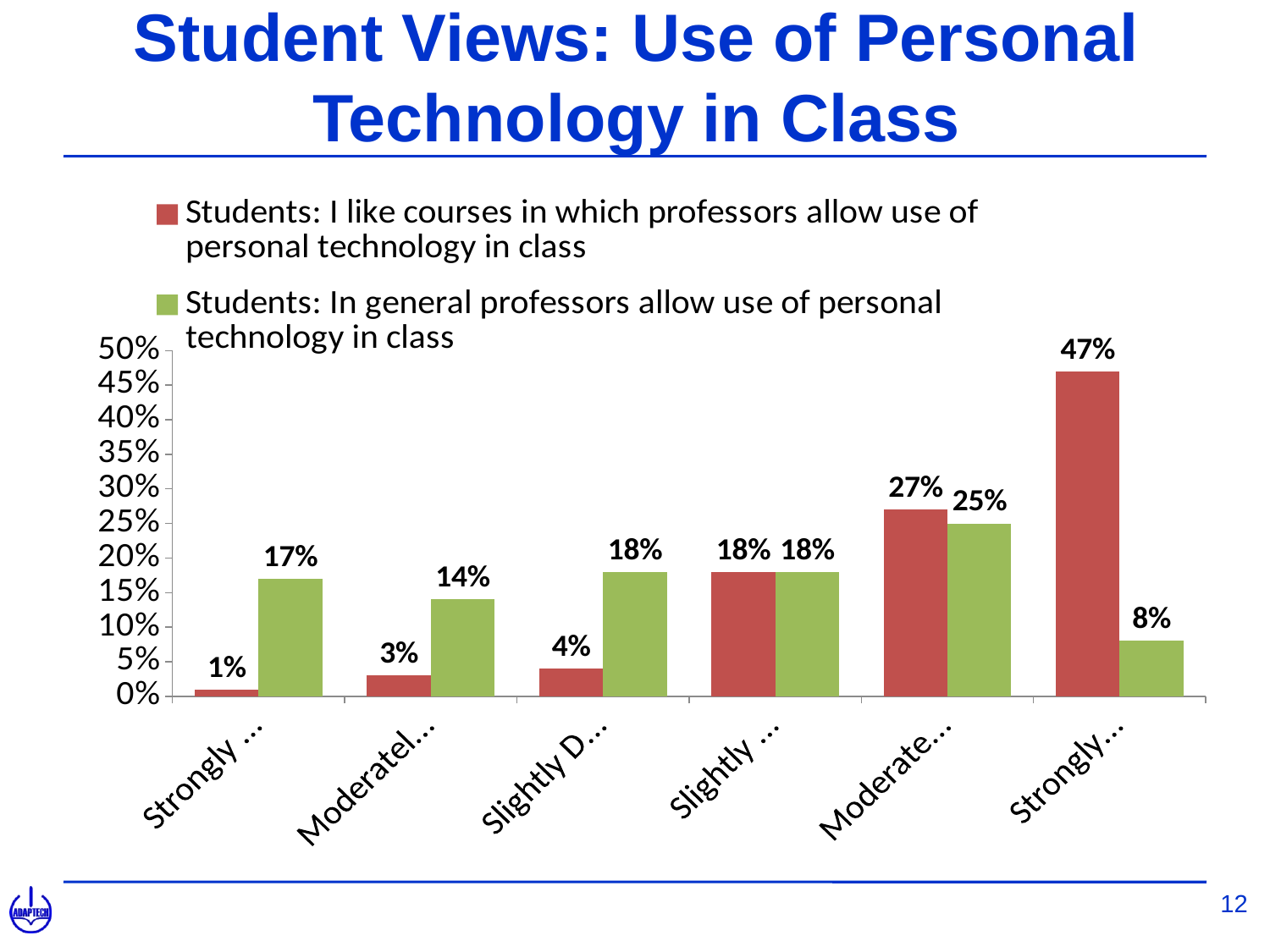
How many series does the legend list? 2 What colour are the bars for the 'Students: In general professors allow use of personal technology in class' series? Green What is the value of the 'Students: In general professors allow use of personal technology in class' series for the leftmost category? 17% Do the values of the 'Students: I like courses in which professors allow use of personal technology in class' series rise or fall from left to right along the x axis? Rise What kind of chart is shown on the slide? Bar chart What is the highest value shown for the 'Students: I like courses in which professors allow use of personal technology in class' series? 47% How many categories are plotted along the x axis? 6 What is the value of the 'Students: I like courses in which professors allow use of personal technology in class' series for the rightmost category? 47% For the leftmost category, what is the difference between the 'In general professors allow...' series value and the 'I like courses...' series value? 16 percentage points For the rightmost category, what is the difference between the 'I like courses...' series value and the 'In general professors allow...' series value? 39 percentage points What is the lowest value shown for the 'Students: In general professors allow use of personal technology in class' series? 8% For the fifth category from the left, which series has the larger value? Students: I like courses in which professors allow use of personal technology in class